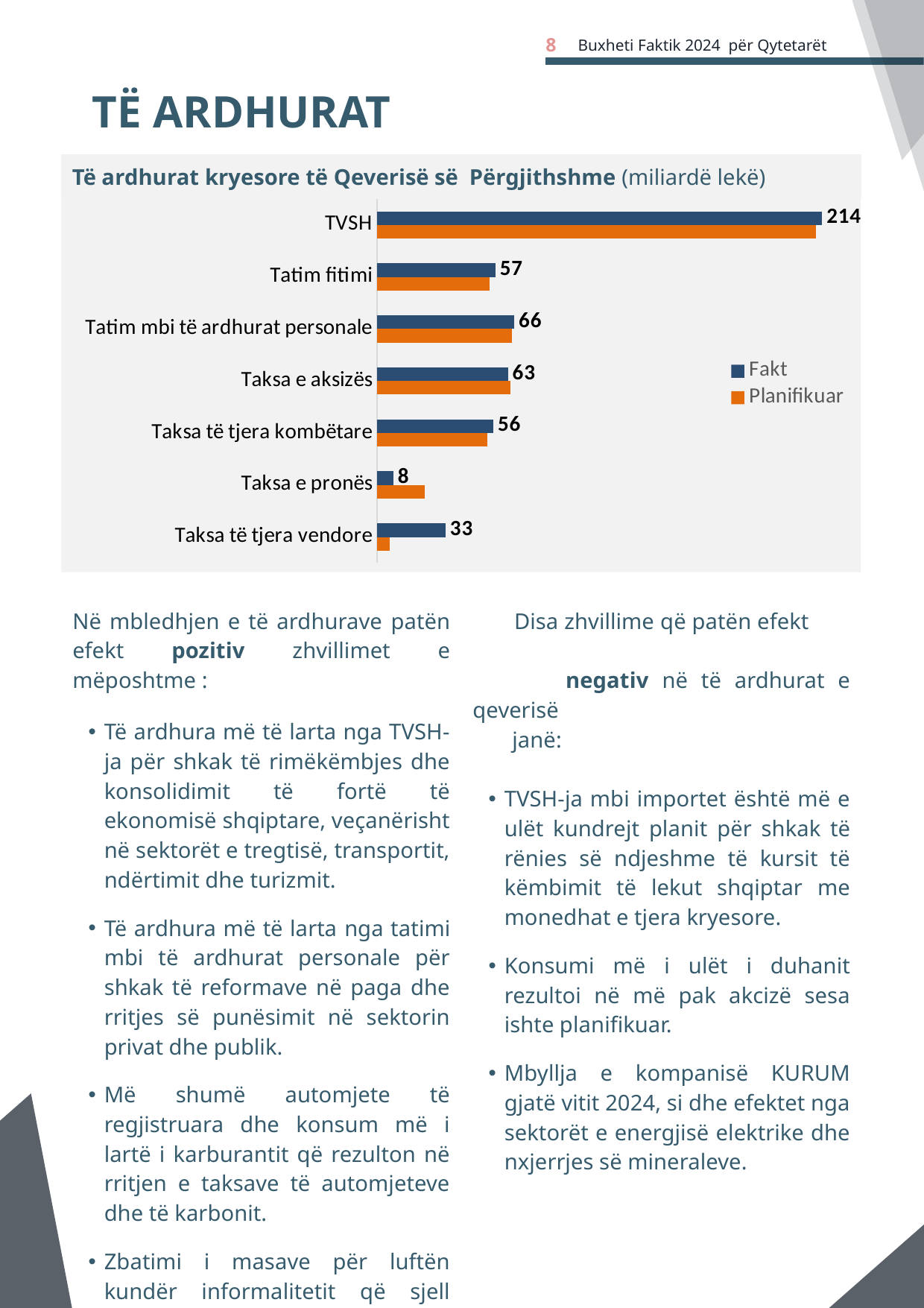
Which category has the highest Fakt value? TVSH What is the Fakt value for Tatim mbi të ardhurat personale? 66 What is the difference between the Fakt values for Tatim mbi të ardhurat personale and Taksa e aksizës? 3 What is the difference between the Fakt values for TVSH and Tatim fitimi? 157 What kind of chart is shown on the slide? Bar chart How many series does the legend list? 2 What is the Fakt value for Taksa e pronës? 8 Which category has the lowest Fakt value? Taksa e pronës For Taksa e pronës, which is larger: the Fakt bar or the Planifikuar bar? Planifikuar What is the Fakt value for TVSH? 214 For Taksa të tjera vendore, which is larger: the Fakt bar or the Planifikuar bar? Fakt How many categories are shown in the chart? 7